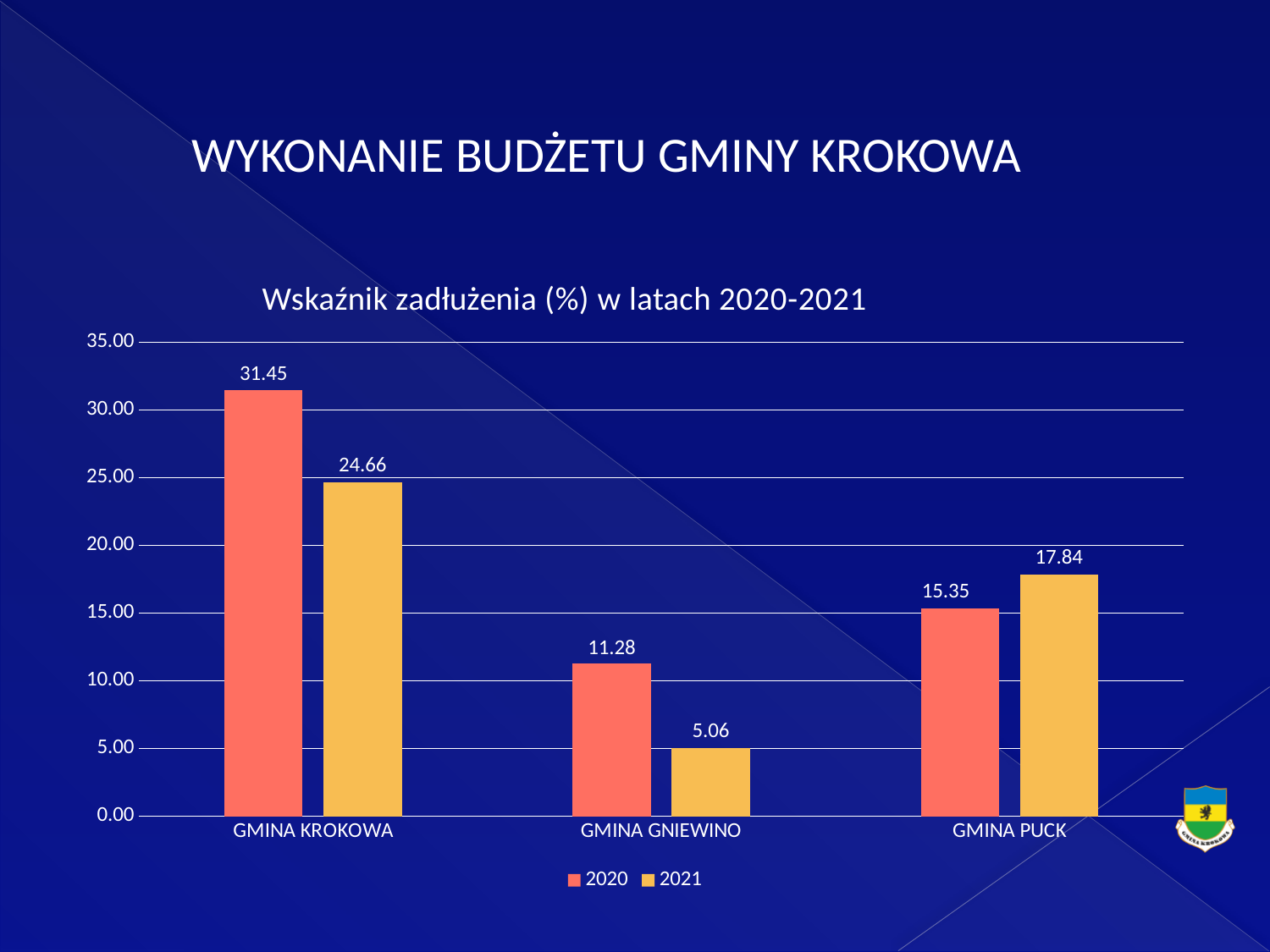
What is the 2020 value for GMINA KROKOWA? 31.45 Which is larger for GMINA PUCK, the 2020 value or the 2021 value? 2021 How many categories are shown on the x axis? 3 Which category has the lowest 2021 value? GMINA GNIEWINO Which series is shown in orange? 2021 What is the 2021 value for GMINA GNIEWINO? 5.06 How many series does the legend list? 2 Which category has the highest 2020 value? GMINA KROKOWA What is the difference between the 2020 and 2021 values for GMINA KROKOWA? 6.79 What is the title of the chart? Wskaźnik zadłużenia (%) w latach 2020-2021 What is the 2021 value for GMINA PUCK? 17.84 What kind of chart is shown on the slide? Bar chart